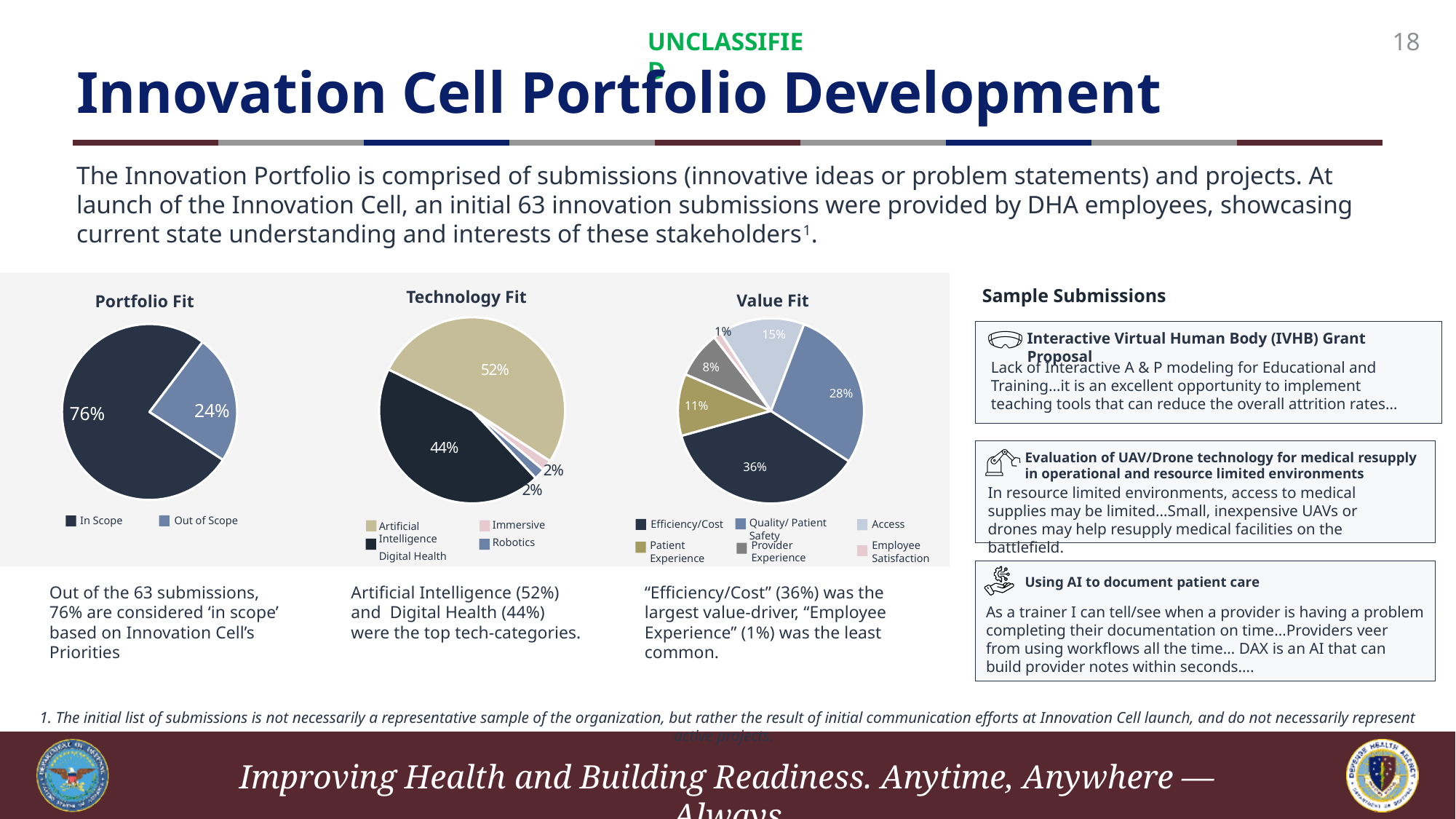
In the Technology Fit chart, which category has the largest share? Artificial Intelligence In the Portfolio Fit chart, what share of submissions is Out of Scope? 24% In the Value Fit chart, what share is Efficiency/Cost? 36% In the Technology Fit chart, what share is Digital Health? 44% In the Portfolio Fit chart, what share of submissions is In Scope? 76% In the Portfolio Fit chart, what is the difference between the In Scope and Out of Scope shares? 52% In the Value Fit chart, which category has the smallest share? Employee Satisfaction How many categories does the legend of the Technology Fit chart list? 4 In the Technology Fit chart, what share is Artificial Intelligence? 52% What kind of chart is the Technology Fit chart? Pie chart In the Value Fit chart, which is larger: Quality/Patient Safety or Access? Quality/Patient Safety How many categories does the legend of the Value Fit chart list? 6